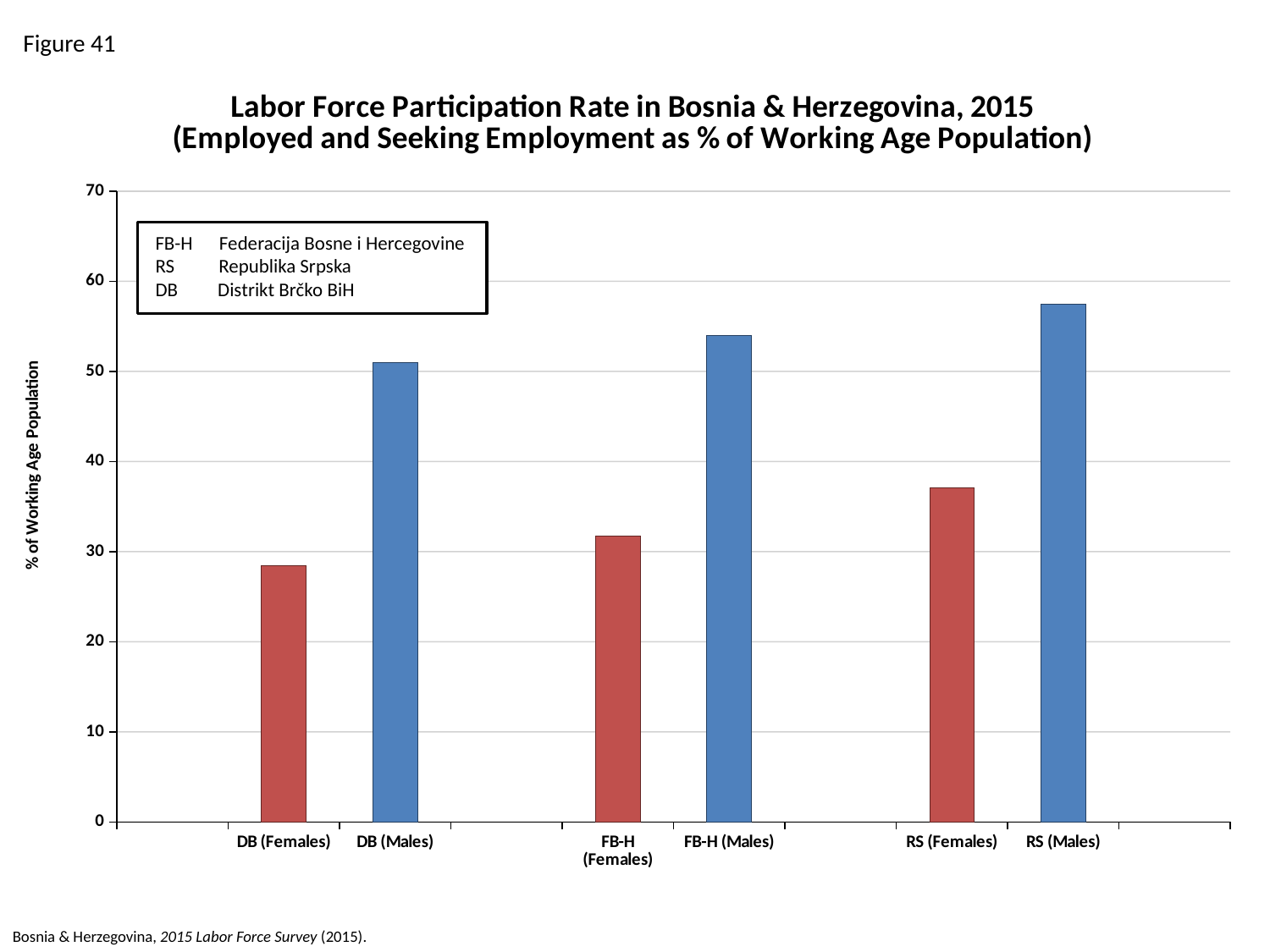
Which is larger, the value for DB (Males) or the value for RS (Males)? RS (Males) Is the value for FB-H (Males) greater or less than 50? greater What is the label of the vertical axis? % of Working Age Population Is the value for RS (Males) greater or less than 50? greater What kind of chart is shown on the slide? bar chart Which category has the lowest labor force participation rate? DB (Females) How many bars are plotted in the chart? 6 Which category has the highest labor force participation rate? RS (Males) Is the value for RS (Females) greater or less than 40? less Which is larger, the value for FB-H (Females) or the value for RS (Females)? RS (Females) According to the key box on the chart, what does the abbreviation RS stand for? Republika Srpska